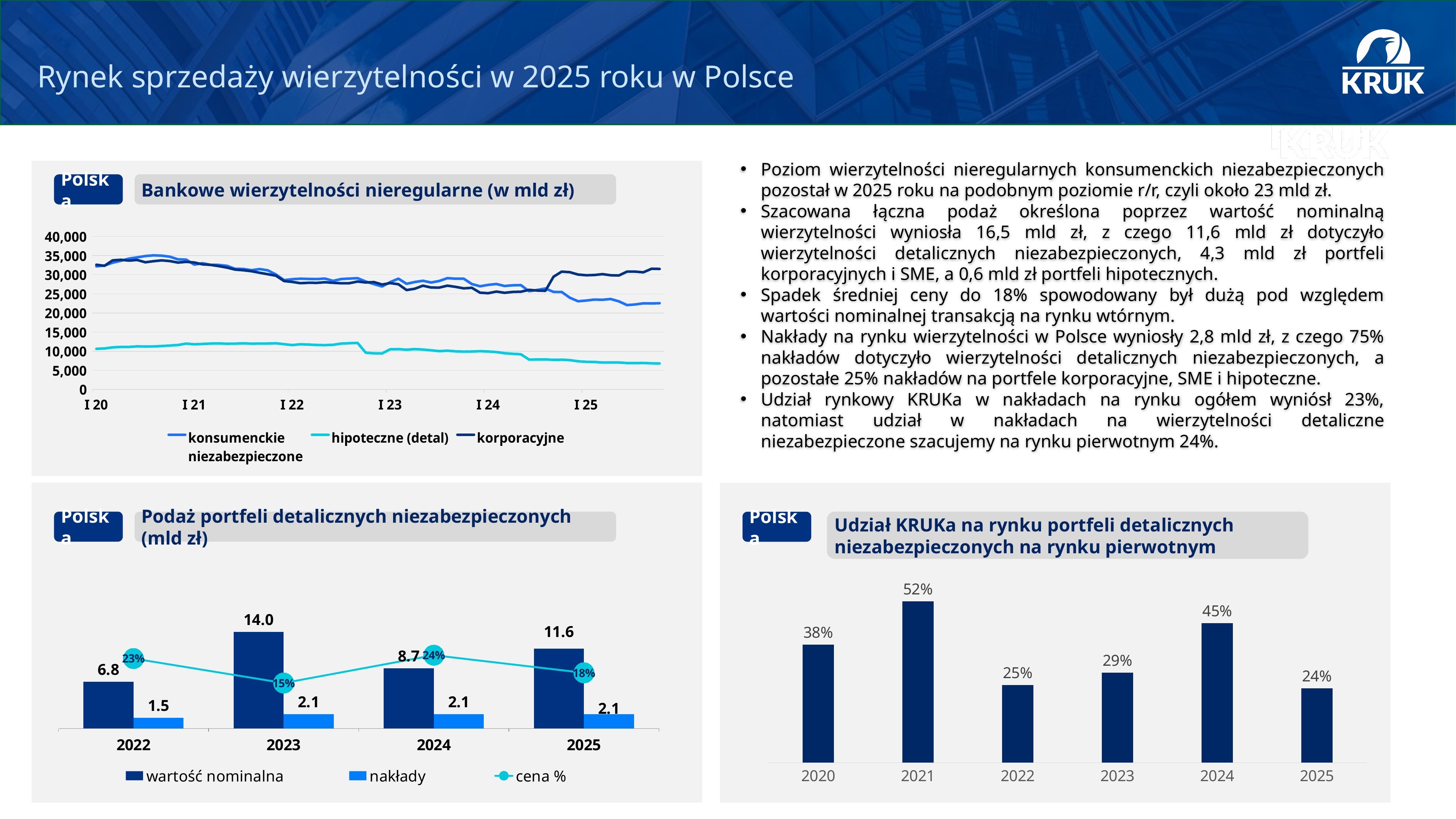
In the chart 'Podaż portfeli detalicznych niezabezpieczonych (mld zł)', what is the nakłady value for 2022? 1.5 In the chart 'Podaż portfeli detalicznych niezabezpieczonych (mld zł)', which year has the highest wartość nominalna? 2023 In the chart 'Udział KRUKa na rynku portfeli detalicznych niezabezpieczonych na rynku pierwotnym', what is the difference between the values for 2024 and 2023? 16% In the chart 'Udział KRUKa na rynku portfeli detalicznych niezabezpieczonych na rynku pierwotnym', what is the value for 2021? 52% In the chart 'Podaż portfeli detalicznych niezabezpieczonych (mld zł)', how many series does the legend list? 3 In the chart 'Podaż portfeli detalicznych niezabezpieczonych (mld zł)', what is the difference between the wartość nominalna for 2025 and 2024? 2.9 In the chart 'Podaż portfeli detalicznych niezabezpieczonych (mld zł)', what is the wartość nominalna for 2023? 14.0 In the chart 'Podaż portfeli detalicznych niezabezpieczonych (mld zł)', what is the cena % for 2025? 18% In the chart 'Bankowe wierzytelności nieregularne (w mld zł)', is the value of the hipoteczne (detal) series at I 25 greater or less than 10,000? less In the chart 'Udział KRUKa na rynku portfeli detalicznych niezabezpieczonych na rynku pierwotnym', how many years are shown? 6 In the chart 'Udział KRUKa na rynku portfeli detalicznych niezabezpieczonych na rynku pierwotnym', which year has the lowest value? 2025 What kind of chart is 'Bankowe wierzytelności nieregularne (w mld zł)'? line chart